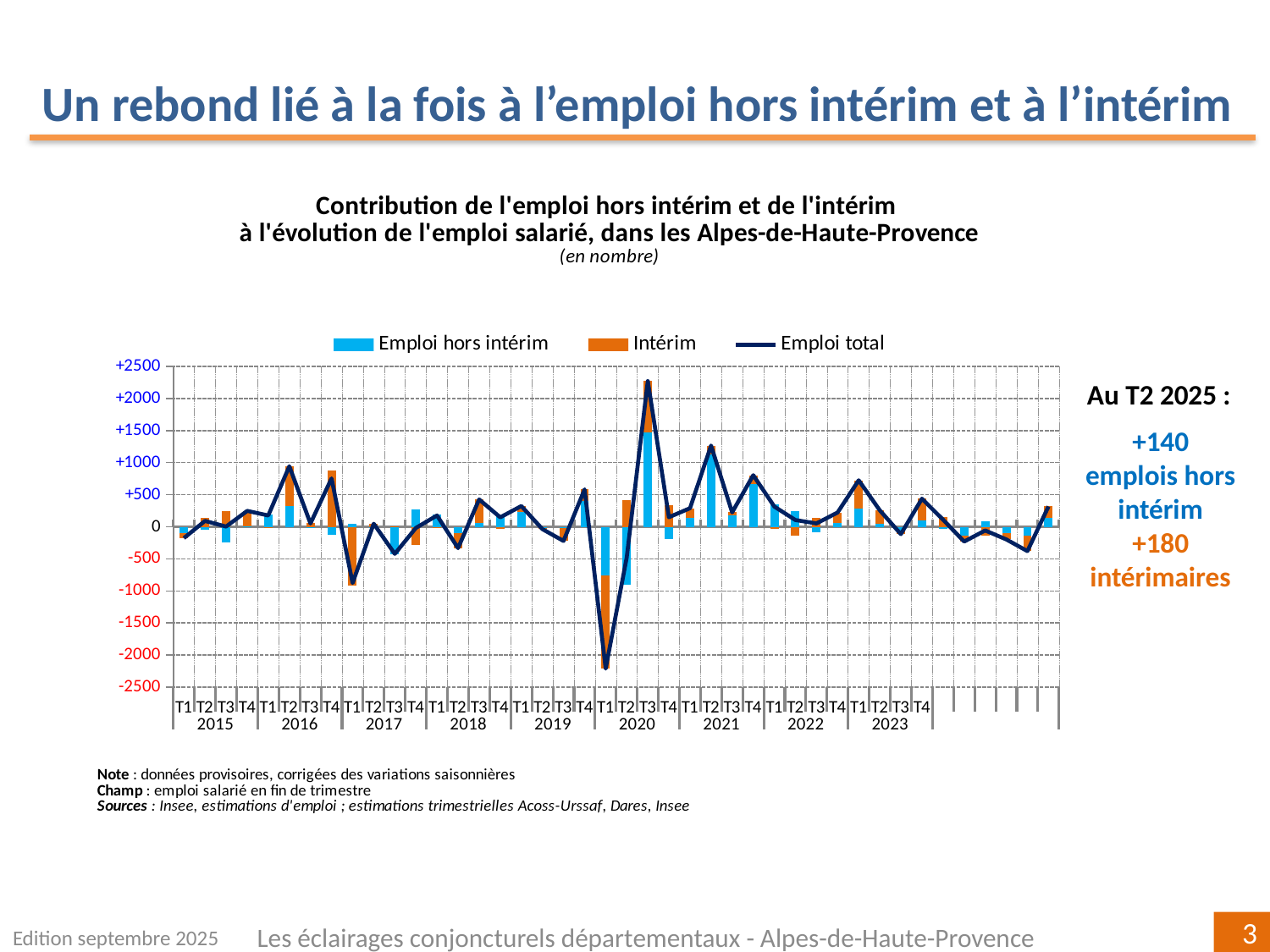
Is the Emploi total value at T1 2017 greater or less than -500? less Is the Emploi total value at T3 2020 greater or less than +2000? greater At T2 2025, how much larger is the intérimaires figure than the emplois hors intérim figure? 40 What kind of chart is shown on the slide? A combined bar and line chart At T3 2020, which bar is taller: Emploi hors intérim or Intérim? Emploi hors intérim How many series does the chart legend list? 3 Which series is drawn as a line rather than bars? Emploi total Is the Emploi total value at T1 2020 greater or less than -2000? less According to the text beside the chart, what is the value for intérimaires at T2 2025? +180 According to the text beside the chart, what is the value for emplois hors intérim at T2 2025? +140 In which quarter does the Emploi total line reach its highest point? T3 2020 In which quarter does the Emploi total line reach its lowest point? T1 2020